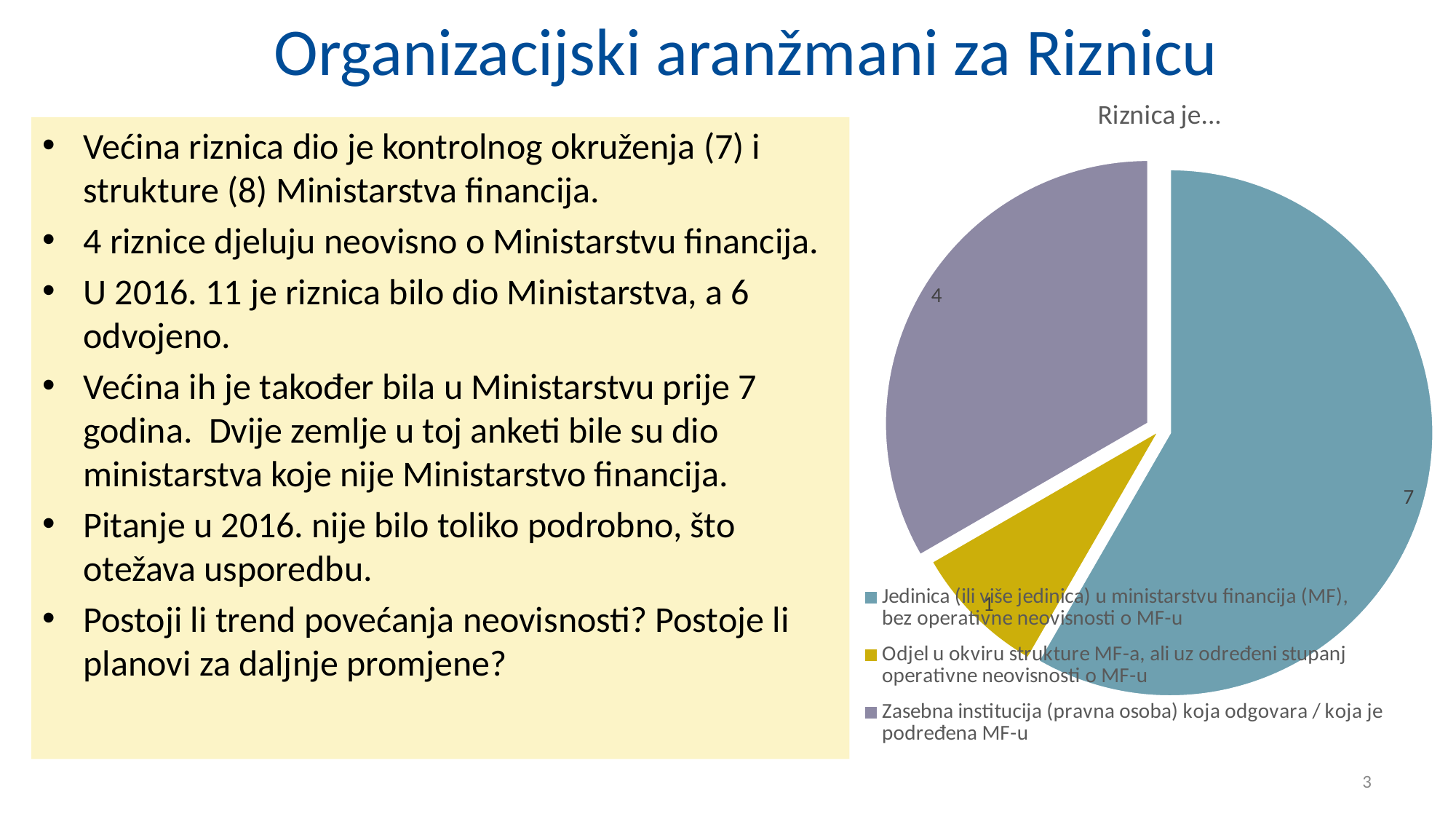
Which category has the smallest slice of the pie chart? Odjel u okviru strukture MF-a, ali uz određeni stupanj operativne neovisnosti o MF-u What kind of chart is shown on the slide? pie chart What is the title of the pie chart? Riznica je... What is the difference between the value for 'Jedinica (ili više jedinica) u ministarstvu financija (MF), bez operativne neovisnosti o MF-u' and the value for 'Zasebna institucija (pravna osoba) koja odgovara / koja je podređena MF-u'? 3 What is the value for 'Odjel u okviru strukture MF-a, ali uz određeni stupanj operativne neovisnosti o MF-u'? 1 How many slices does the pie chart have? 3 Which is larger: the value for 'Zasebna institucija (pravna osoba) koja odgovara / koja je podređena MF-u' or the value for 'Odjel u okviru strukture MF-a, ali uz određeni stupanj operativne neovisnosti o MF-u'? Zasebna institucija (pravna osoba) koja odgovara / koja je podređena MF-u Which category has the largest slice of the pie chart? Jedinica (ili više jedinica) u ministarstvu financija (MF), bez operativne neovisnosti o MF-u What is the value for 'Jedinica (ili više jedinica) u ministarstvu financija (MF), bez operativne neovisnosti o MF-u'? 7 What is the value for 'Zasebna institucija (pravna osoba) koja odgovara / koja je podređena MF-u'? 4 What is the total of all the values shown in the pie chart? 12 How many entries does the legend of the pie chart list? 3